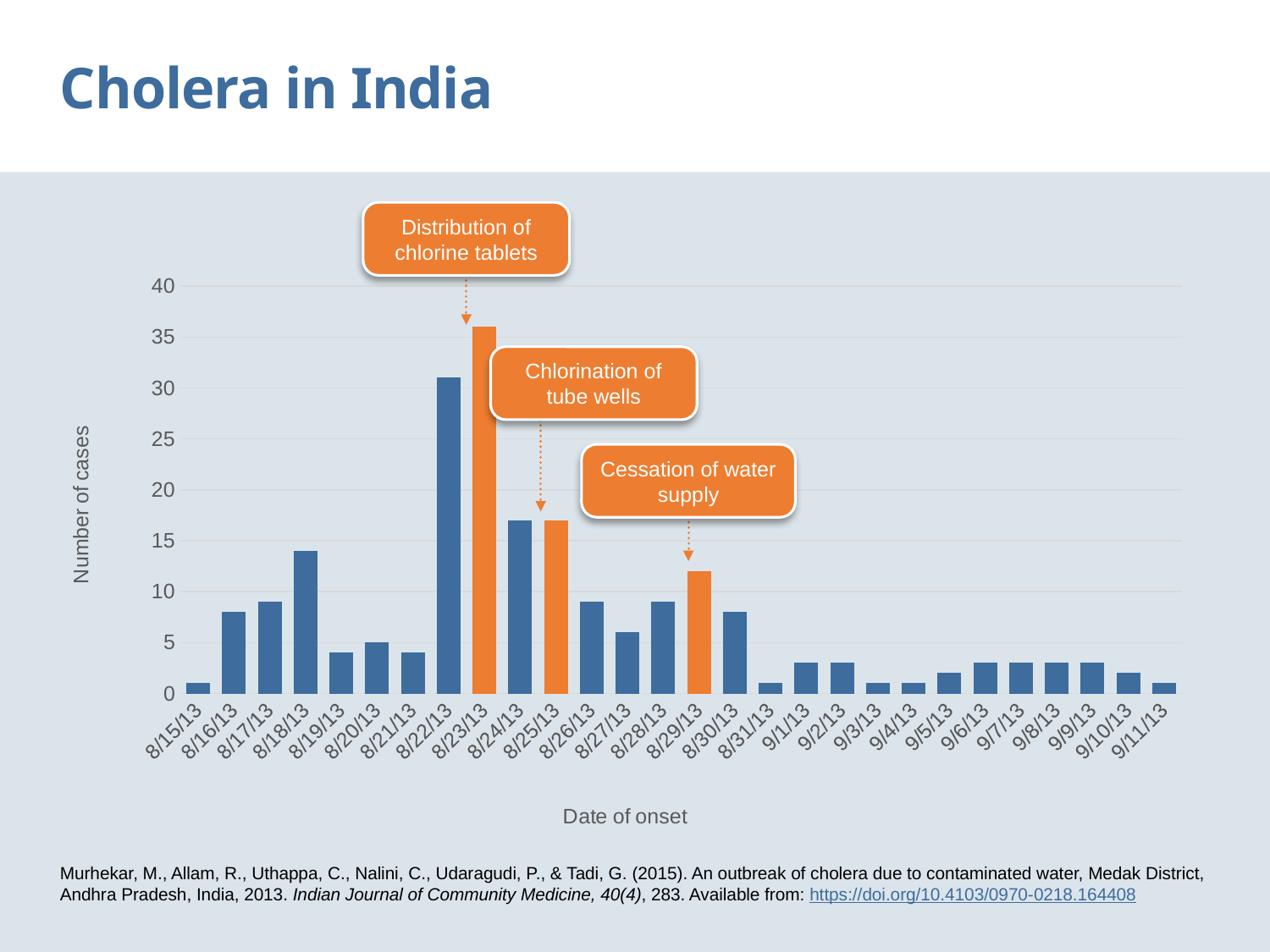
Is the number of cases for 8/24/13 greater or less than 20? less Which date of onset has the highest number of cases? 8/23/13 What kind of chart is shown on the slide? bar chart Which has more cases, 8/18/13 or 8/29/13? 8/18/13 Which intervention is annotated above the bar for 8/23/13? Distribution of chlorine tablets How many dates of onset are shown on the x axis? 28 What is the label of the y axis? Number of cases Is the number of cases for 8/18/13 greater or less than 10? greater Is the number of cases for 8/23/13 greater or less than 35? greater Which has more cases, 8/22/13 or 8/23/13? 8/23/13